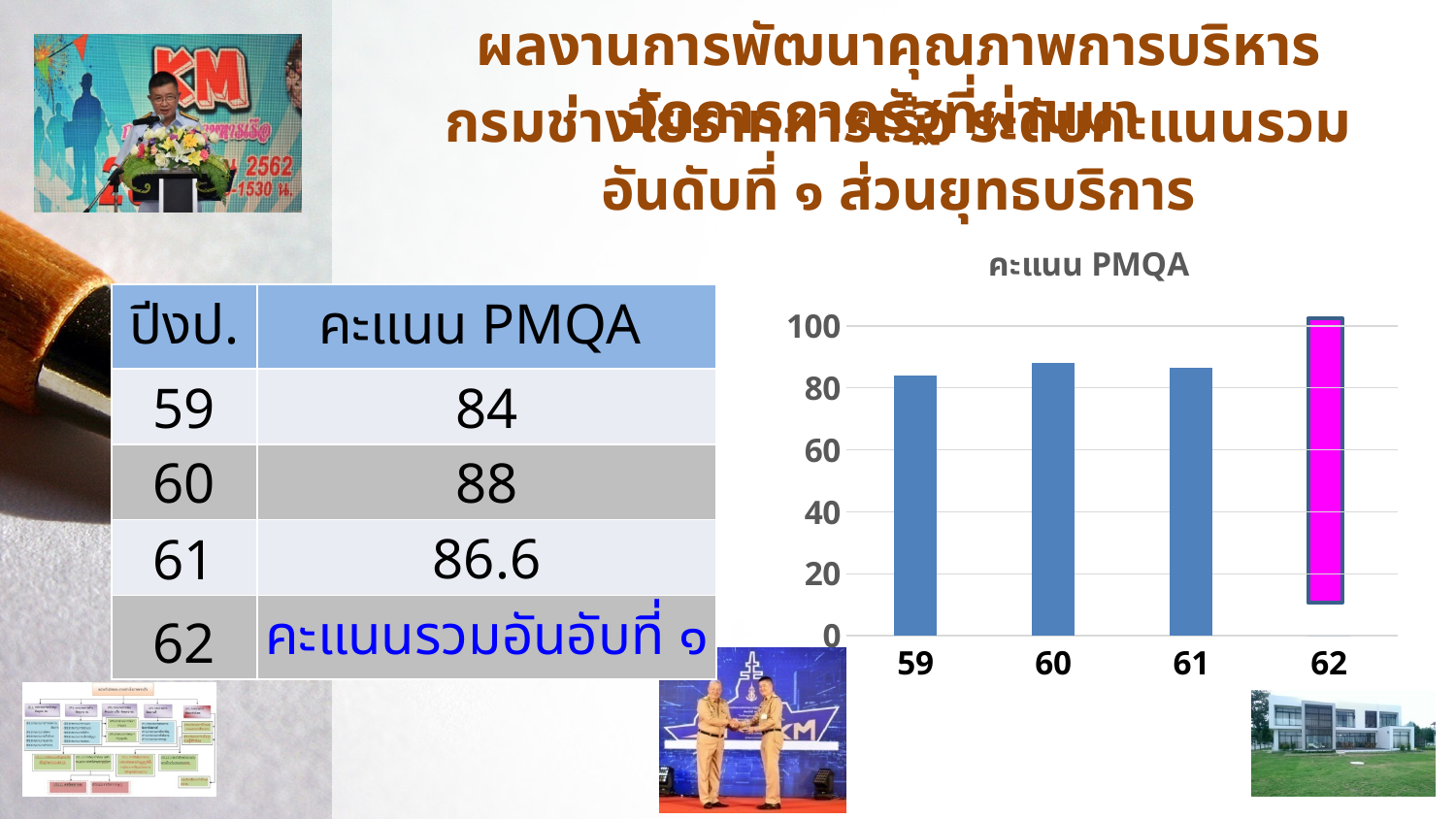
What is the PMQA score for year 60? 88 How many categories are shown on the x axis of the chart? 4 What kind of chart is shown on the slide? bar chart Is the value for year 59 greater or less than 80? greater What is the PMQA score for year 61? 86.6 What colour is the bar for year 62? magenta Which is larger, the PMQA score for year 60 or for year 61? 60 What is the PMQA score for year 59? 84 What is the difference between the PMQA scores for years 60 and 59? 4 What is the title of the chart? คะแนน PMQA Among years 59, 60 and 61, which has the highest PMQA score? 60 Among years 59, 60 and 61, which has the lowest PMQA score? 59